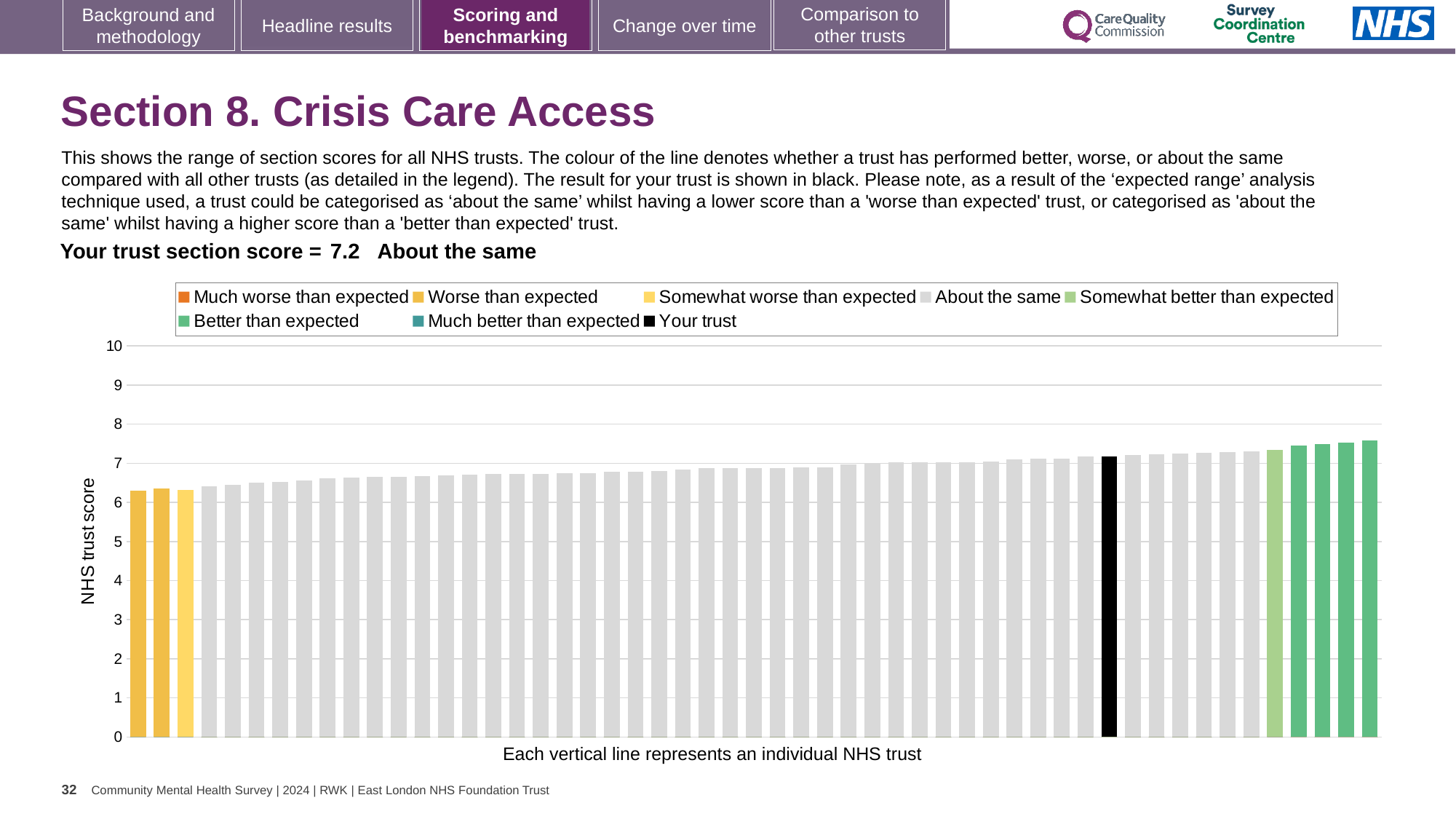
Is the value of the black 'Your trust' bar greater or less than 7? greater Which is larger: the black 'Your trust' bar or the leftmost yellow bar? the black 'Your trust' bar Is the value of the lowest bar in the chart greater or less than 7? less What kind of chart is shown on the slide? bar chart How many bars are coloured as 'Worse than expected' (yellow)? 2 How many entries does the chart legend list? 8 Which category is your trust placed in for this section? About the same What is the section score for your trust shown on the slide? 7.2 Do the bar values rise or fall from left to right along the x axis? rise How many bars are coloured as 'Better than expected' (green)? 4 Is the value of the highest bar in the chart greater or less than 8? less What is the title of the vertical axis? NHS trust score